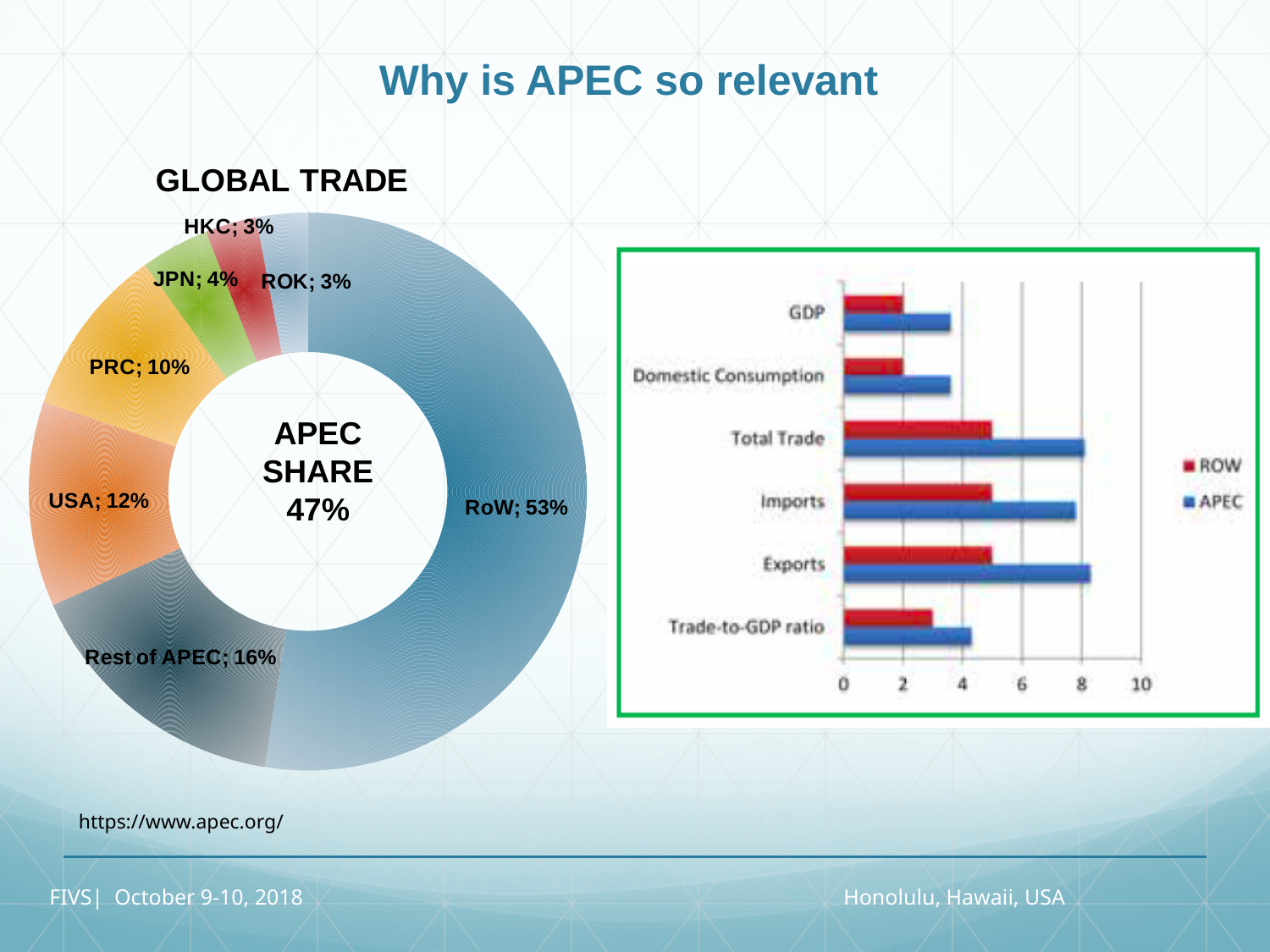
How many categories are shown in the GLOBAL TRADE chart? 7 What APEC share is printed in the centre of the GLOBAL TRADE chart? 47% In the GLOBAL TRADE chart, what is the difference between the USA share and the PRC share? 2% How many categories are shown in the bar chart on the right? 6 In the bar chart on the right, is the ROW value for Trade-to-GDP ratio greater or less than 4? less In the GLOBAL TRADE chart, what share is shown for Rest of APEC? 16% In the GLOBAL TRADE chart, which category has the largest share? RoW In the GLOBAL TRADE chart, what share is shown for RoW? 53% In the GLOBAL TRADE chart, what share is shown for USA? 12% How many series does the legend of the bar chart on the right list? 2 In the GLOBAL TRADE chart, which is larger, PRC or JPN? PRC What kind of chart is the chart on the right of the slide? bar chart